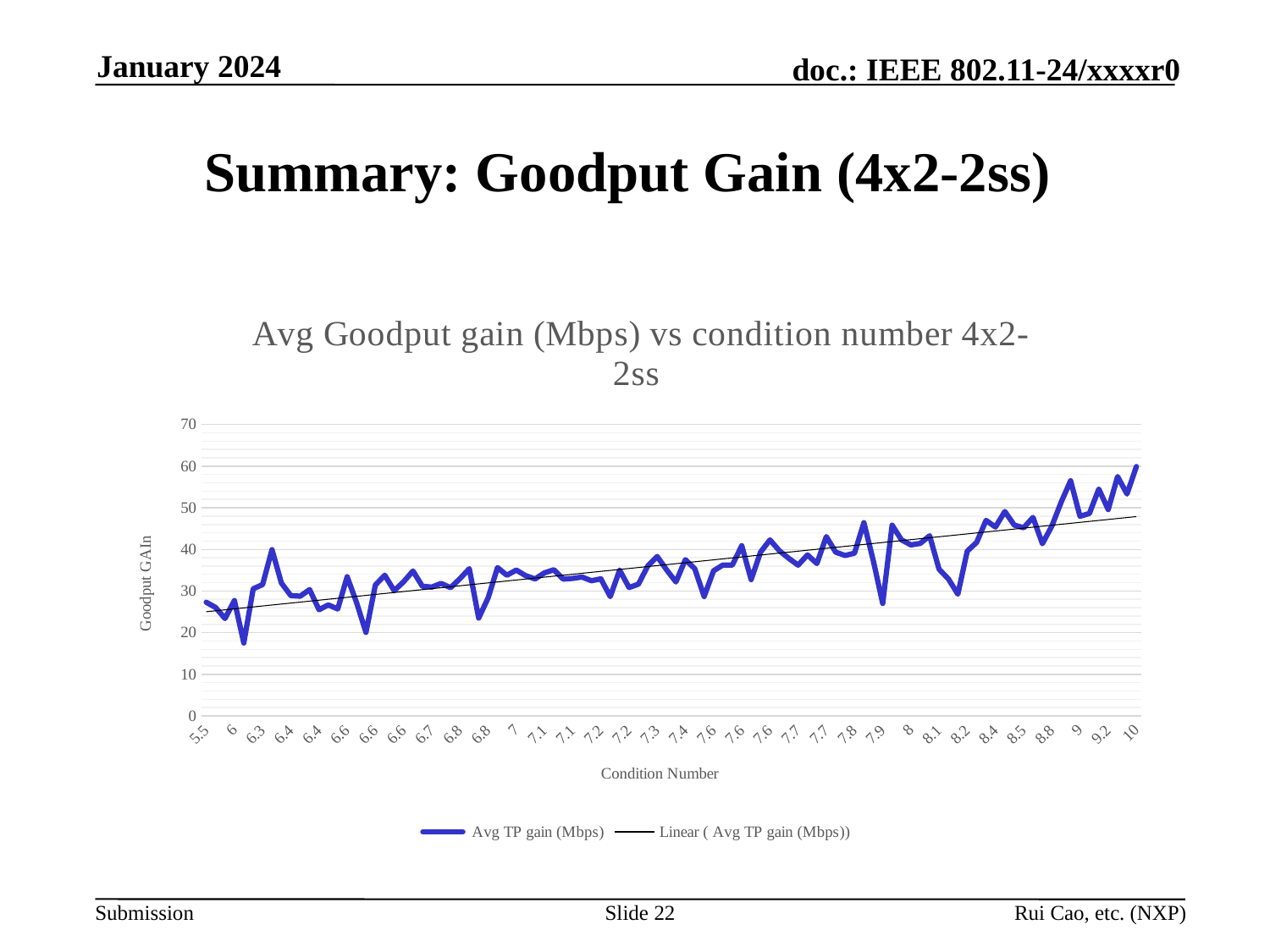
How many series does the chart legend list? 2 Which is larger, the Avg TP gain at condition number 5.5 or at condition number 10? 10 What kind of chart is shown on the slide? line chart Is the Avg TP gain value at condition number 10 greater or less than 70? less At which condition number does the Avg TP gain reach its highest value? 10 Is the Avg TP gain value at condition number 5.5 greater or less than 30? less What are the two entries in the chart legend? Avg TP gain (Mbps) and Linear ( Avg TP gain (Mbps)) Overall, do the Avg TP gain values rise or fall as the condition number increases along the x axis? rise What is the title of the chart? Avg Goodput gain (Mbps) vs condition number 4x2-2ss Is the Avg TP gain value at condition number 10 greater or less than 50? greater